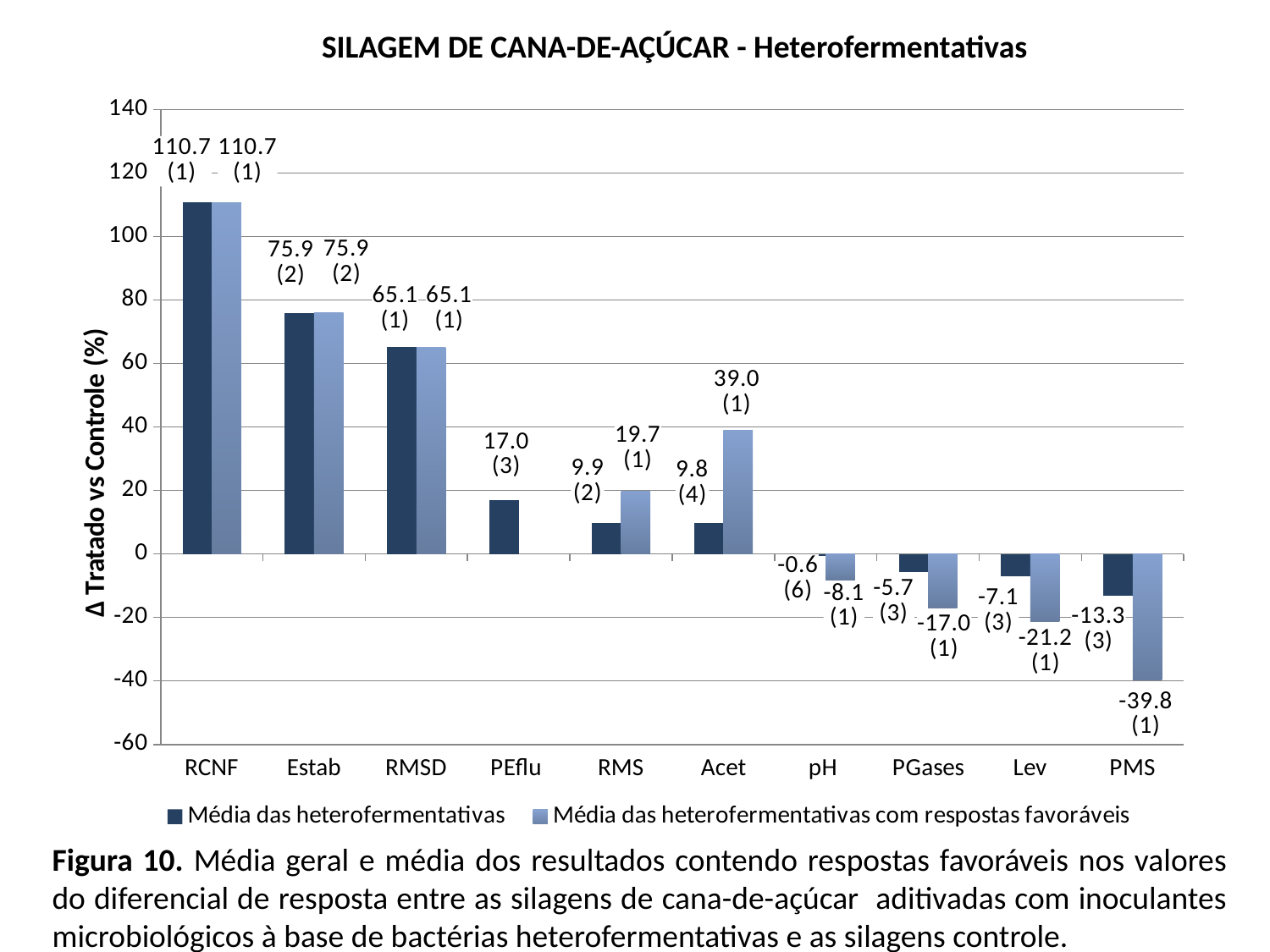
Which category has the lowest value in the 'Média das heterofermentativas com respostas favoráveis' series? PMS For Acet, what is the difference between the 'Média das heterofermentativas com respostas favoráveis' value and the 'Média das heterofermentativas' value? 29.2 What is the value for pH in the 'Média das heterofermentativas' series? -0.6 In the 'Média das heterofermentativas com respostas favoráveis' series, which is larger: RMS or Acet? Acet For Lev, what is the difference between the 'Média das heterofermentativas' value and the 'Média das heterofermentativas com respostas favoráveis' value? 14.1 What is the value for Acet in the 'Média das heterofermentativas com respostas favoráveis' series? 39.0 What is the value for PMS in the 'Média das heterofermentativas' series? -13.3 Which category has the highest value in the 'Média das heterofermentativas' series? RCNF Is the value for RCNF in the 'Média das heterofermentativas' series greater or less than 100? greater What kind of chart is shown on the slide? bar chart How many categories are shown on the x axis? 10 How many series does the legend list? 2